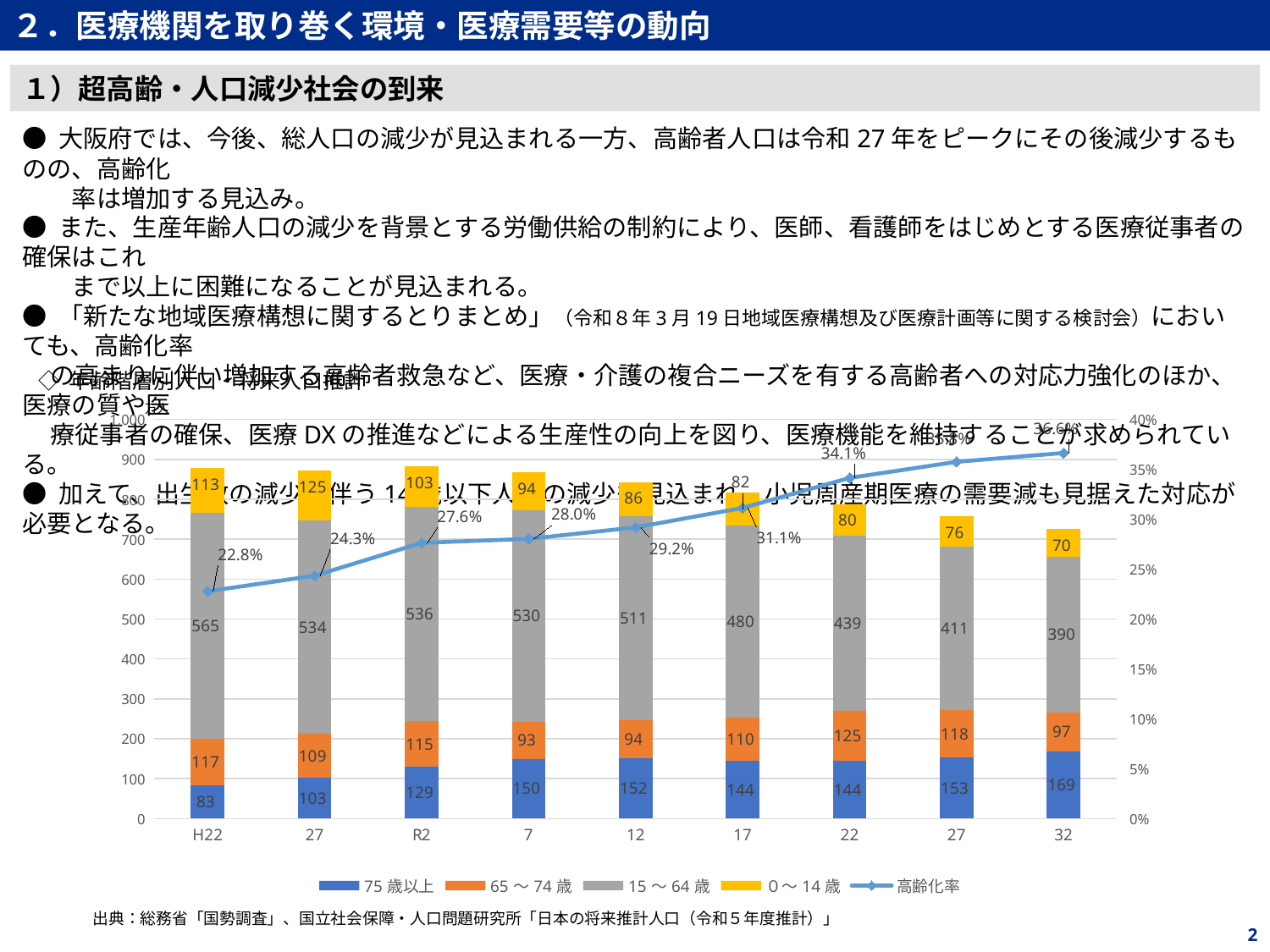
What is the value of the 15～64歳 series for the category 32? 390 What is the 高齢化率 value for R2? 27.6% Which category has the lowest value for the 0～14歳 series? 32 How many series does the legend list? 5 How many categories are shown on the x axis? 9 Which category has the highest value for the 15～64歳 series? H22 What kind of chart is this? stacked bar chart with a line Which has the larger 65～74歳 value, the category 22 or the category 32? 22 What is the value of the 0～14歳 series for the category 17? 82 Does the 高齢化率 line rise or fall from H22 to 32? rises What is the value of the 75歳以上 series for H22? 83 What is the difference between the 75歳以上 value for the category 32 and for H22? 86